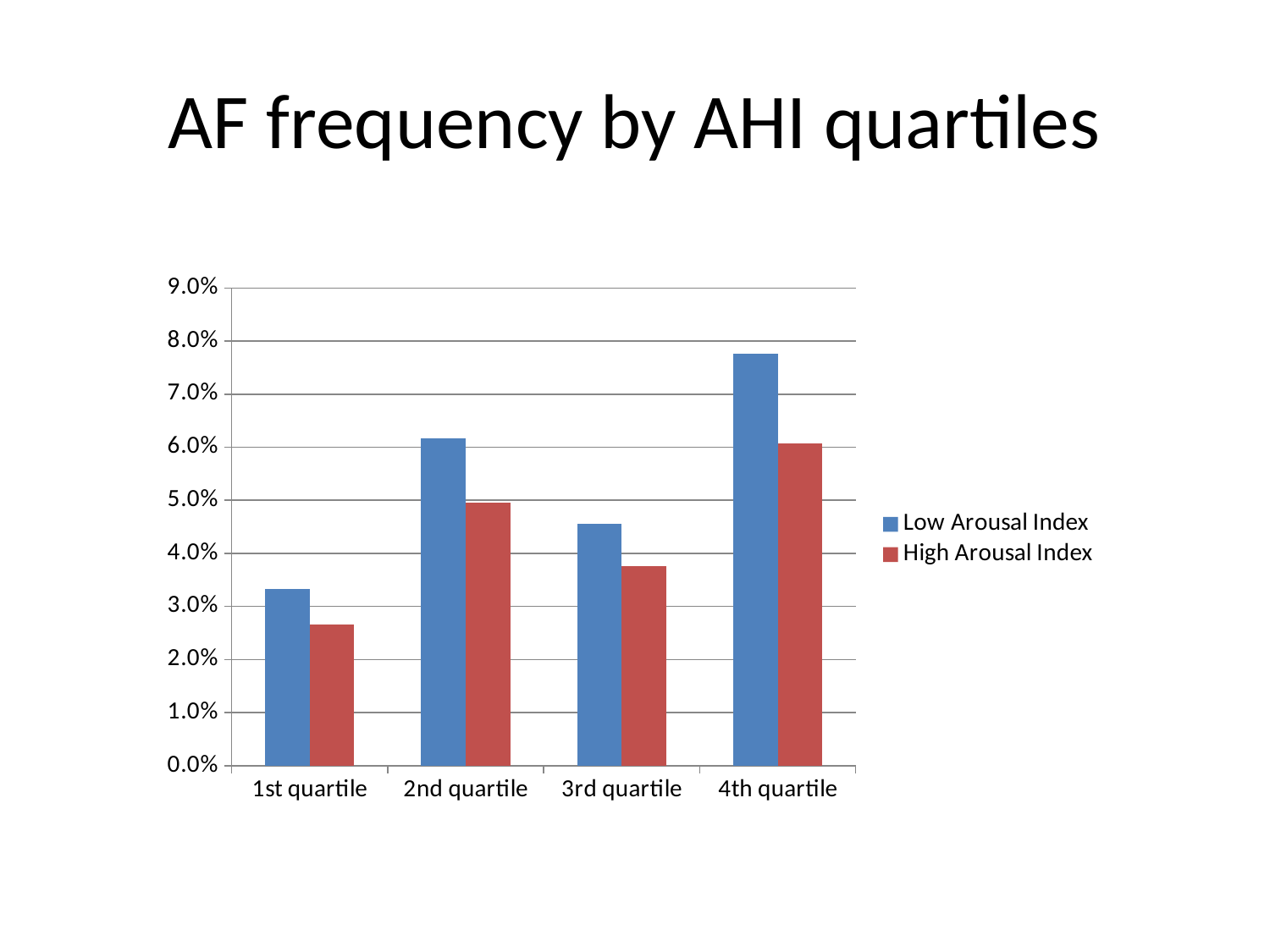
Is the Low Arousal Index value for the 2nd quartile greater or less than 5.0%? greater Which quartile has the highest Low Arousal Index value? 4th quartile In the 3rd quartile, which series has the larger value, Low Arousal Index or High Arousal Index? Low Arousal Index How many quartile categories are shown on the x axis? 4 Is the High Arousal Index value for the 1st quartile greater or less than 3.0%? less Is the Low Arousal Index value for the 4th quartile greater or less than 7.0%? greater What is the title of the chart on the slide? AF frequency by AHI quartiles Which quartile has the lowest High Arousal Index value? 1st quartile Which series is shown in red? High Arousal Index How many series does the legend list? 2 What kind of chart is shown on the slide? bar chart